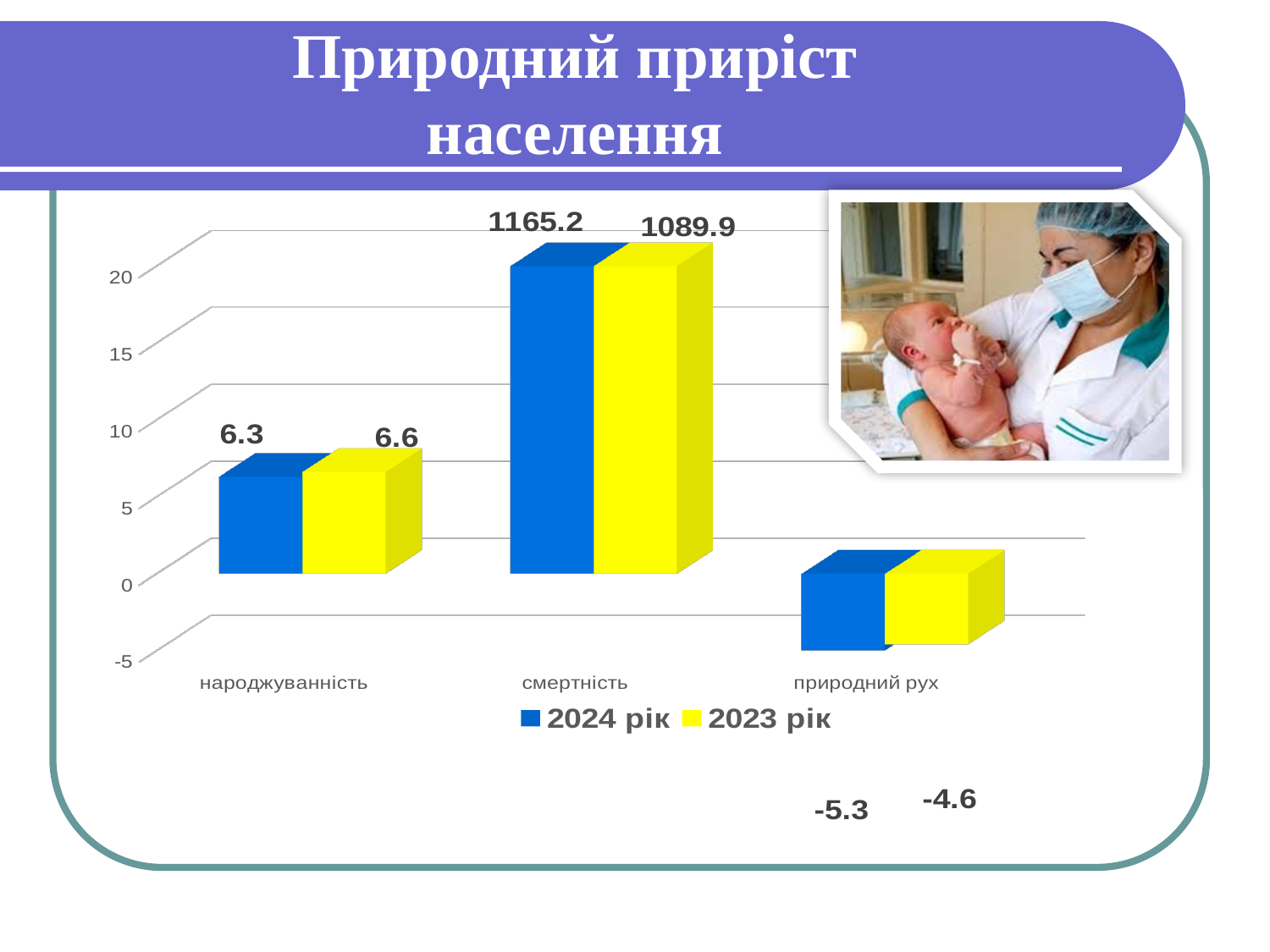
What is the value for народжуваність in the 2023 рік series? 6.6 What is the data label shown for смертність in the 2024 рік series? 1165.2 How many series does the legend list? 2 What is the difference between the 2023 рік and 2024 рік values for народжуваність? 0.3 What is the value for природний рух in the 2024 рік series? -5.3 What type of chart is shown on the slide? bar chart What is the value for природний рух in the 2023 рік series? -4.6 Which is larger for народжуваність: the 2024 рік value or the 2023 рік value? 2023 рік What is the value for народжуваність in the 2024 рік series? 6.3 What is the data label shown for смертність in the 2023 рік series? 1089.9 Which category has the highest values in the chart? смертність Which category has the lowest values in the chart? природний рух